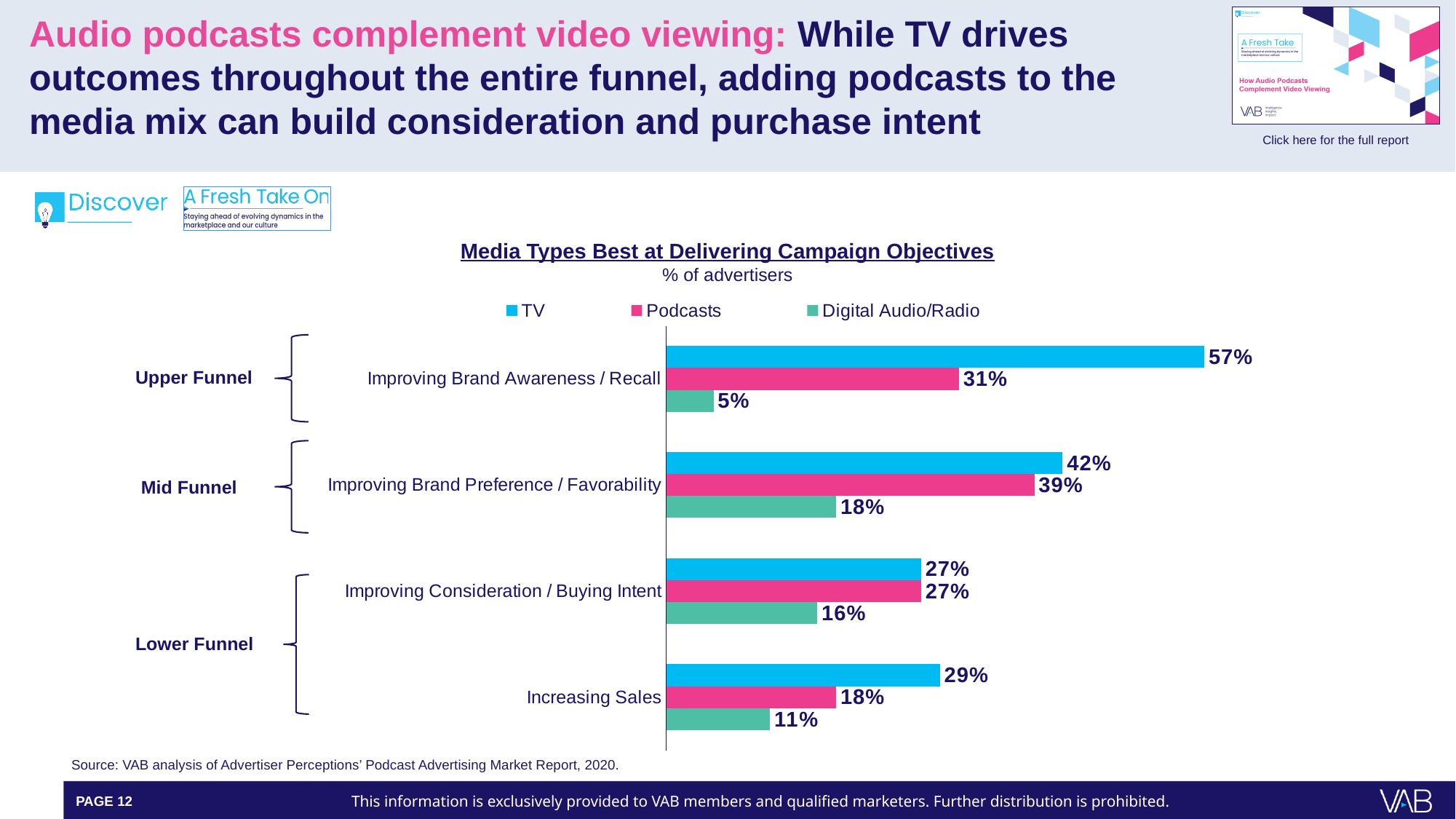
What is the value for Podcasts for Improving Brand Preference / Favorability? 39% How many series does the legend list? 3 What is the title of the chart? Media Types Best at Delivering Campaign Objectives How many campaign objectives are shown in the chart? 4 What is the value for Digital Audio/Radio for Increasing Sales? 11% For Increasing Sales, which is larger: the TV value or the Podcasts value? TV Which campaign objective has the lowest value for Digital Audio/Radio? Improving Brand Awareness / Recall What kind of chart is shown on the slide? Bar chart What is the difference between the TV and Podcasts values for Improving Brand Awareness / Recall? 26% What percentage of advertisers say TV is best at Improving Brand Awareness / Recall? 57% Which campaign objective has the highest value for TV? Improving Brand Awareness / Recall Which funnel stage label covers both Improving Consideration / Buying Intent and Increasing Sales? Lower Funnel